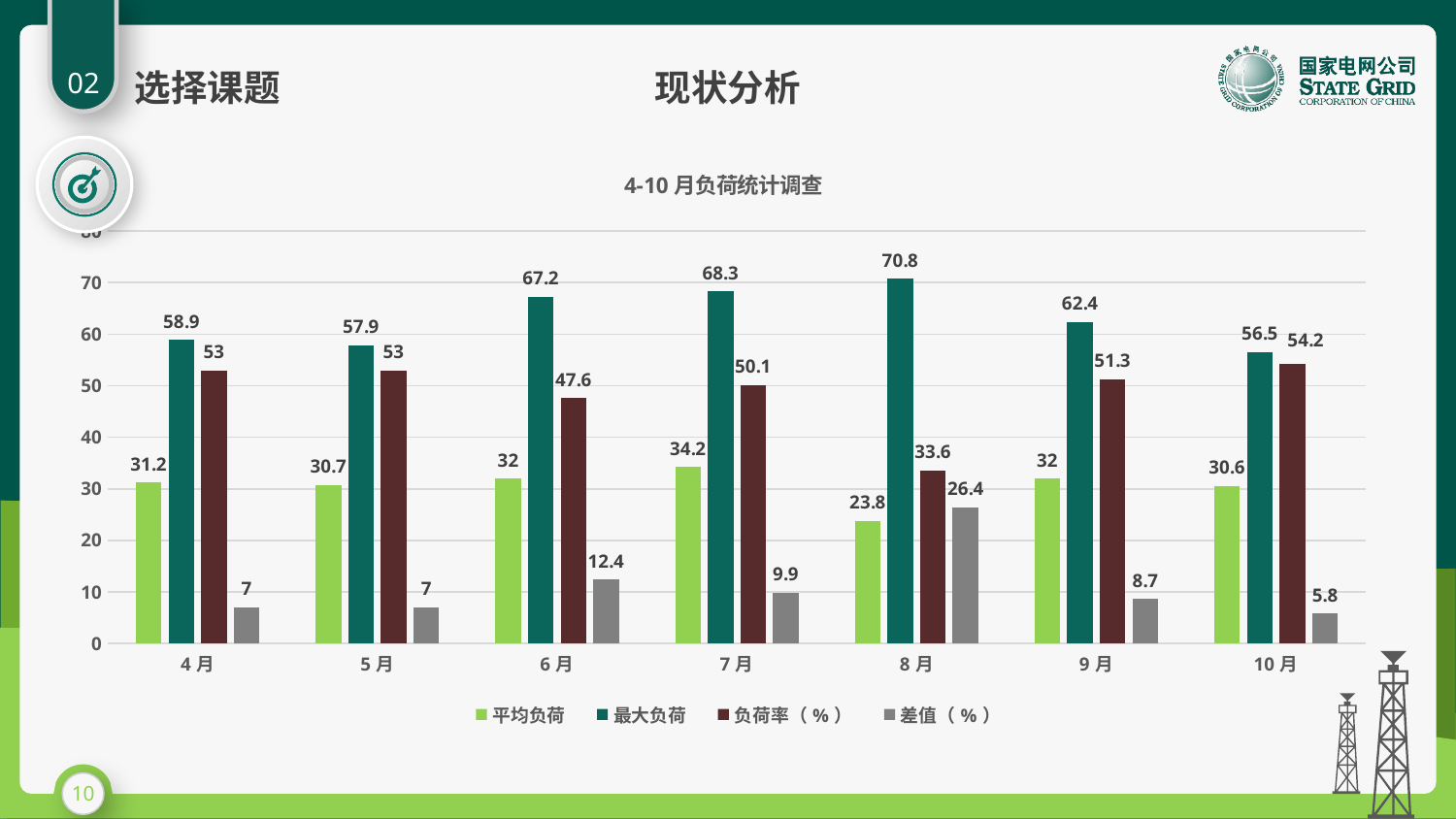
What is the value of 差值（%） for 10 月? 5.8 What is the value of 平均负荷 for 7 月? 34.2 What kind of chart is shown on the slide? Bar chart What is the title of the chart? 4-10 月负荷统计调查 Which is larger, the 负荷率（%） for 10 月 or for 9 月? 10 月 What is the difference between 最大负荷 and 平均负荷 for 8 月? 47 What is the value of 负荷率（%） for 6 月? 47.6 How many series does the legend list? 4 What is the value of 最大负荷 for 8 月? 70.8 How many months are shown on the x axis? 7 Which month has the highest 最大负荷? 8 月 Which month has the lowest 平均负荷? 8 月